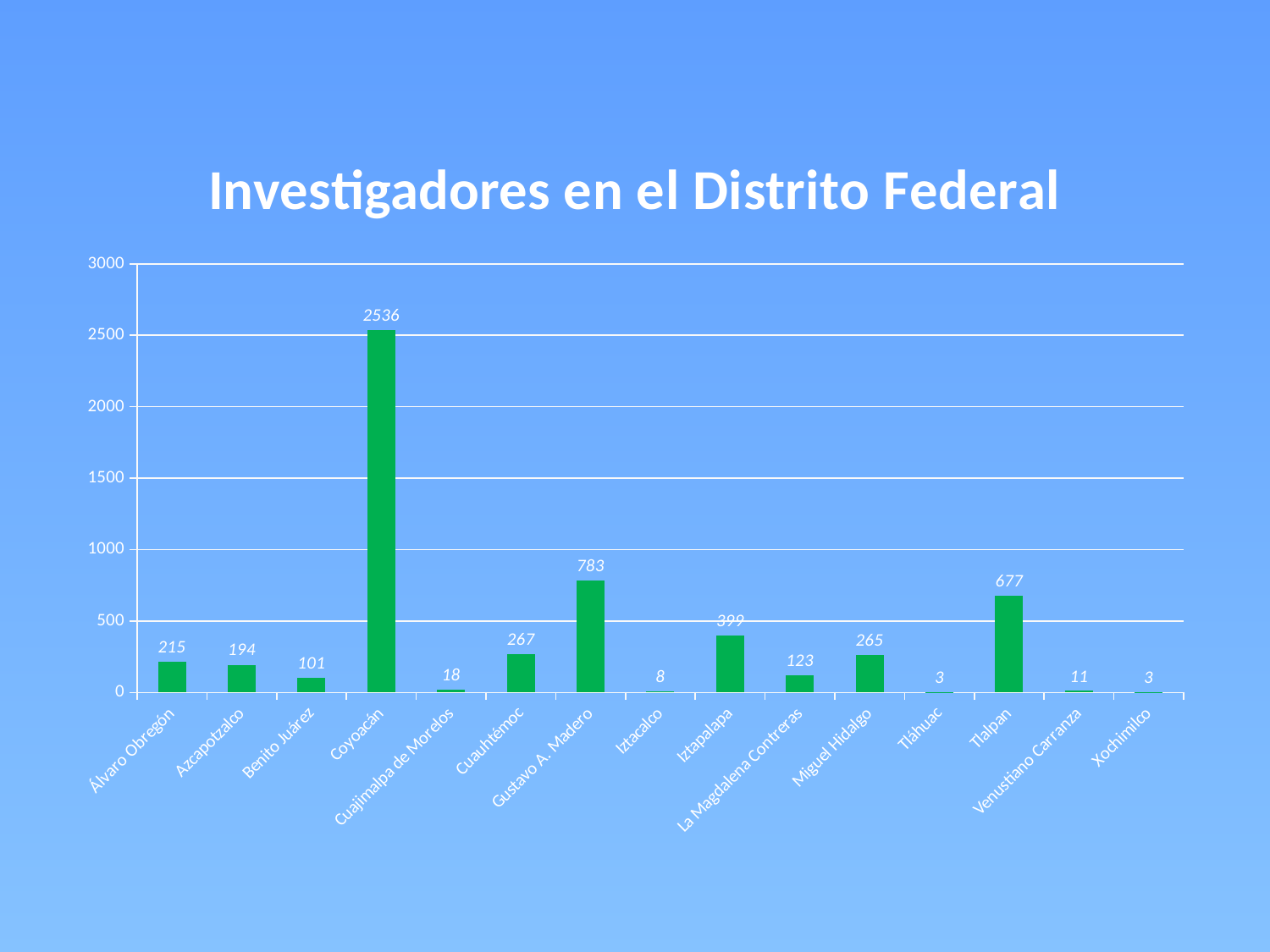
Is the value for Gustavo A. Madero greater or less than 1000? less What is the value for Gustavo A. Madero? 783 What is the value for La Magdalena Contreras? 123 What kind of chart is shown on the slide? bar chart What is the difference between the values for Álvaro Obregón and Azcapotzalco? 21 What is the value for Venustiano Carranza? 11 What is the value for Coyoacán? 2536 Which category has the highest value? Coyoacán What is the title of the chart? Investigadores en el Distrito Federal What is the difference between the values for Gustavo A. Madero and Tlalpan? 106 How many categories are shown on the x axis? 15 Which is larger, the value for Iztapalapa or the value for Cuauhtémoc? Iztapalapa